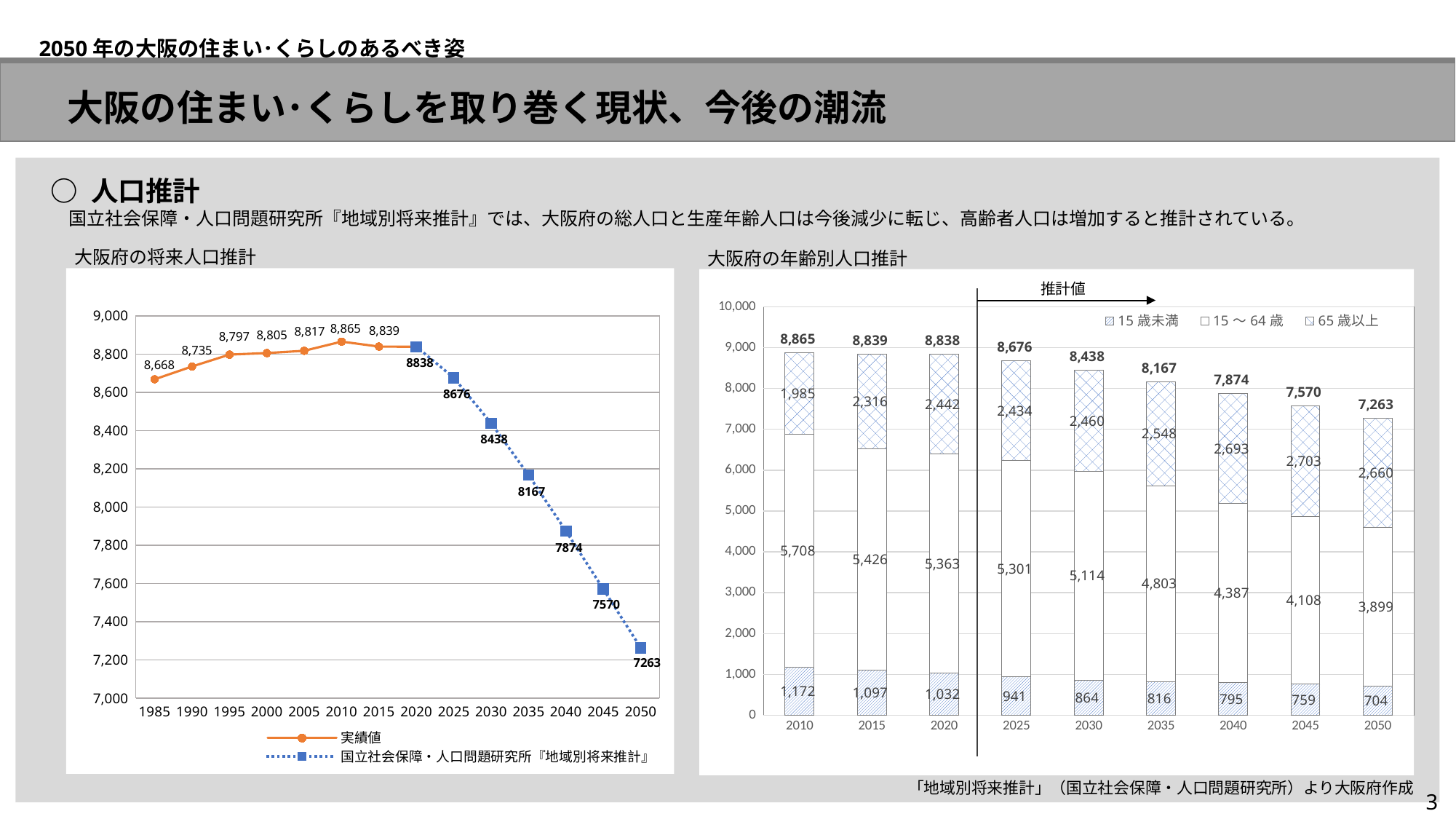
In the chart titled 大阪府の将来人口推計, what is the value for 2010? 8,865 In the chart titled 大阪府の将来人口推計, which year has the lowest value? 2050 In the chart titled 大阪府の年齢別人口推計, which is larger, the 15歳未満 value for 2010 or for 2050? 2010 In the chart titled 大阪府の将来人口推計, how many series does the legend list? 2 In the chart titled 大阪府の将来人口推計, do the values rise or fall from 2020 to 2050? fall In the chart titled 大阪府の年齢別人口推計, how many years are shown on the x axis? 9 In the chart titled 大阪府の年齢別人口推計, what is the value for 65歳以上 in 2050? 2,660 In the chart titled 大阪府の年齢別人口推計, what is the total of the stacked bar for 2030? 8,438 In the chart titled 大阪府の将来人口推計, what is the value for 2050? 7263 In the chart titled 大阪府の年齢別人口推計, what is the value for 15～64歳 in 2010? 5,708 In the chart titled 大阪府の将来人口推計, which year has the highest value? 2010 In the chart titled 大阪府の将来人口推計, what is the difference between the values for 1985 and 2010? 197